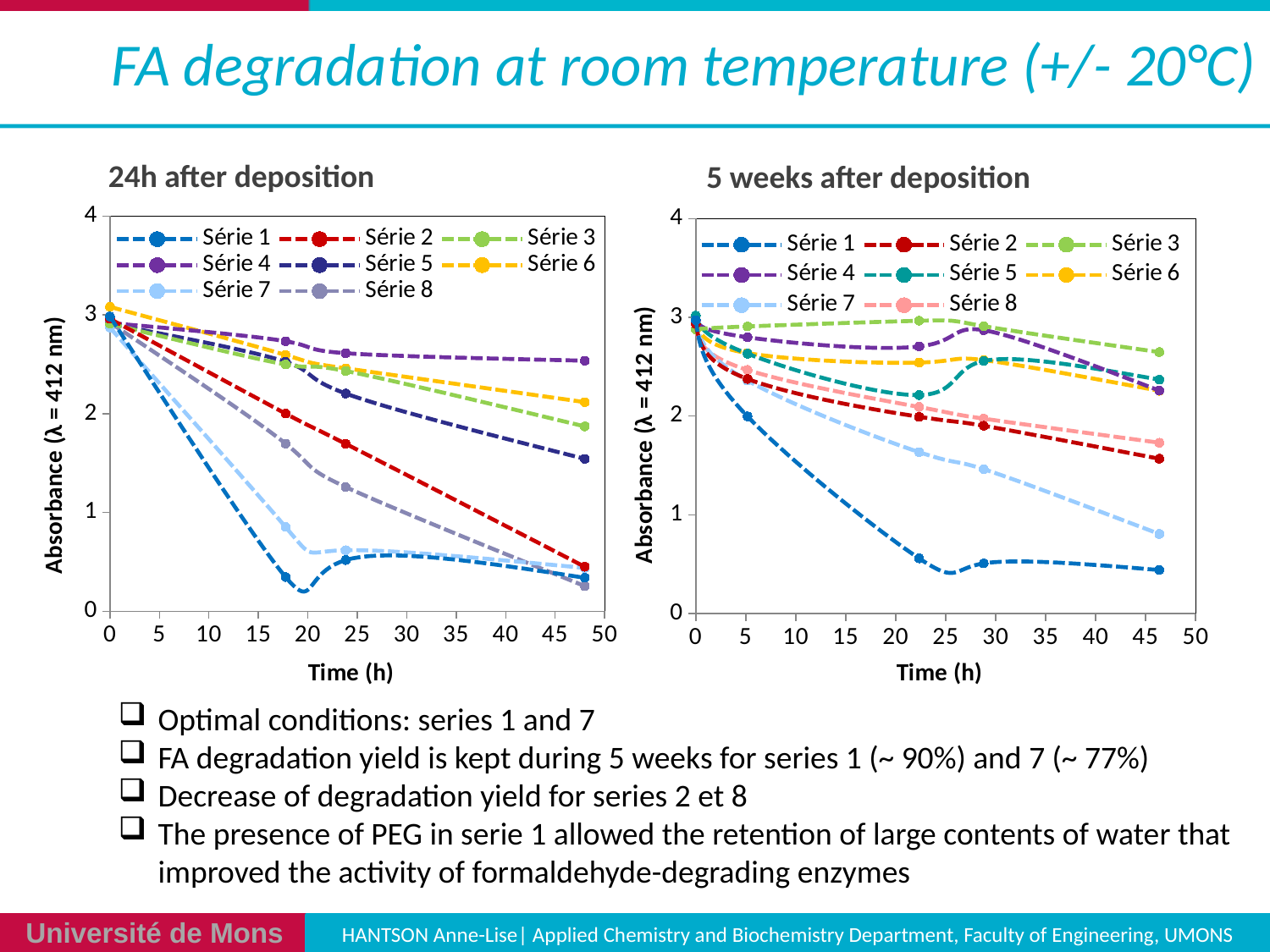
How many series does the legend of the '5 weeks after deposition' chart list? 8 What is the y-axis label of the '24h after deposition' chart? Absorbance (λ = 412 nm) In the '5 weeks after deposition' chart, does the absorbance of Série 1 rise or fall overall along the time axis? fall In the '24h after deposition' chart, is the value for Série 4 at 48 h greater or less than 2? greater How many series does the legend of the '24h after deposition' chart list? 8 What kind of chart is the '24h after deposition' chart? line chart In the '5 weeks after deposition' chart, is the value for Série 7 at the final time point greater or less than 1? less In the '24h after deposition' chart, which series has the lowest absorbance at around 18 h? Série 1 In the '24h after deposition' chart, which series has the highest absorbance at the final time point (48 h)? Série 4 In the '5 weeks after deposition' chart, which series has the highest absorbance at the final time point? Série 3 In the '5 weeks after deposition' chart, at the final time point, which is larger: Série 2 or Série 7? Série 2 In the '5 weeks after deposition' chart, which series has the lowest absorbance at the final time point? Série 1